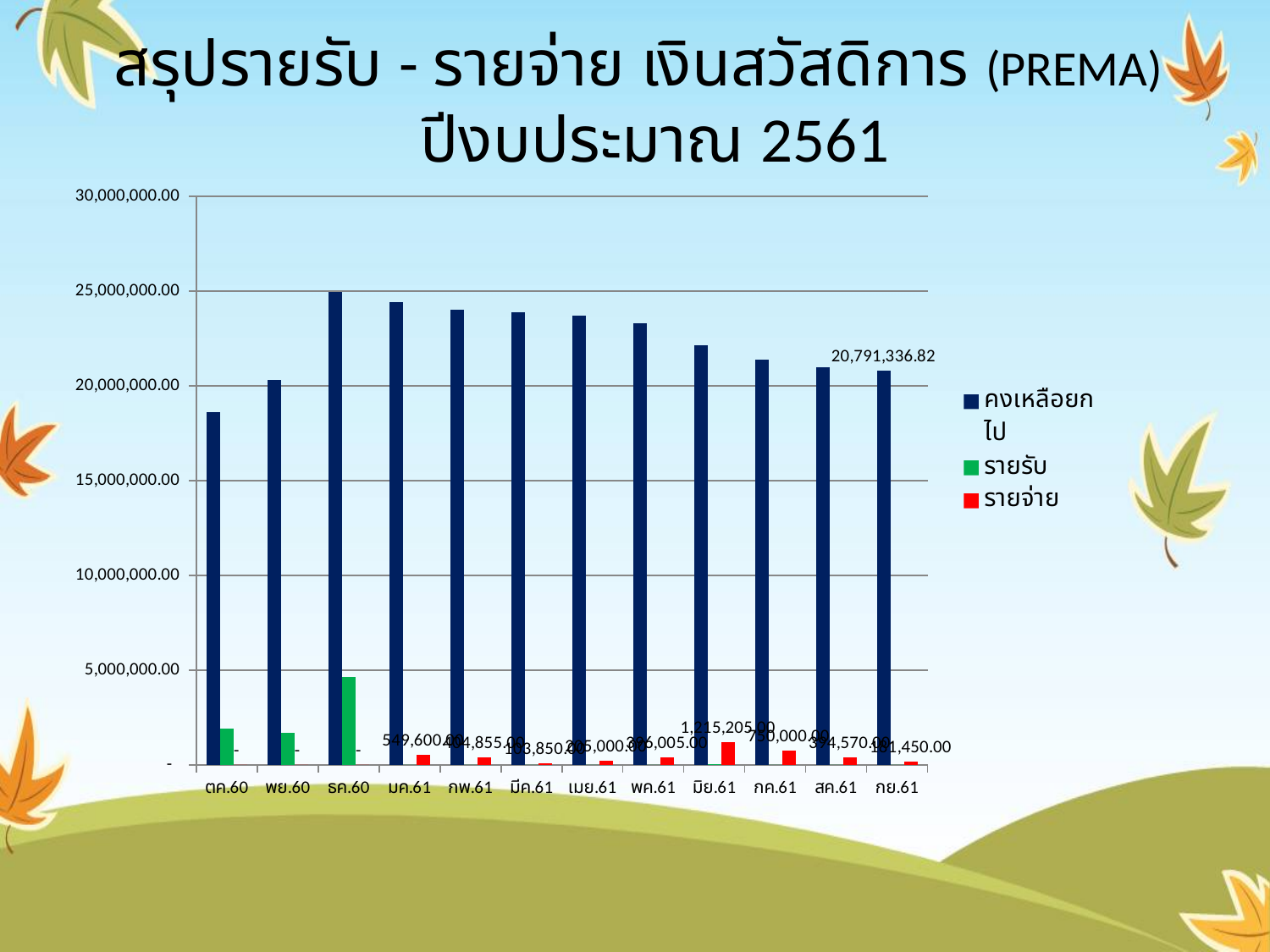
What is the value of รายจ่าย for มค.61? 549,600.00 Is the รายรับ value for ธค.60 greater or less than 5,000,000.00? less How many series does the legend list? 3 What kind of chart is shown on the slide? bar chart Which month has the lowest คงเหลือยกไป value? ตค.60 What is the value of รายจ่าย for มีค.61? 103,850.00 What is the value of คงเหลือยกไป for กย.61? 20,791,336.82 From ธค.60 to กย.61, do the คงเหลือยกไป values rise or fall? fall How many months (categories) are shown on the x axis? 12 Is the คงเหลือยกไป value for ตค.60 greater or less than 20,000,000.00? less Which is larger, the รายรับ value for ธค.60 or for ตค.60? ธค.60 Which month has the highest คงเหลือยกไป value? ธค.60